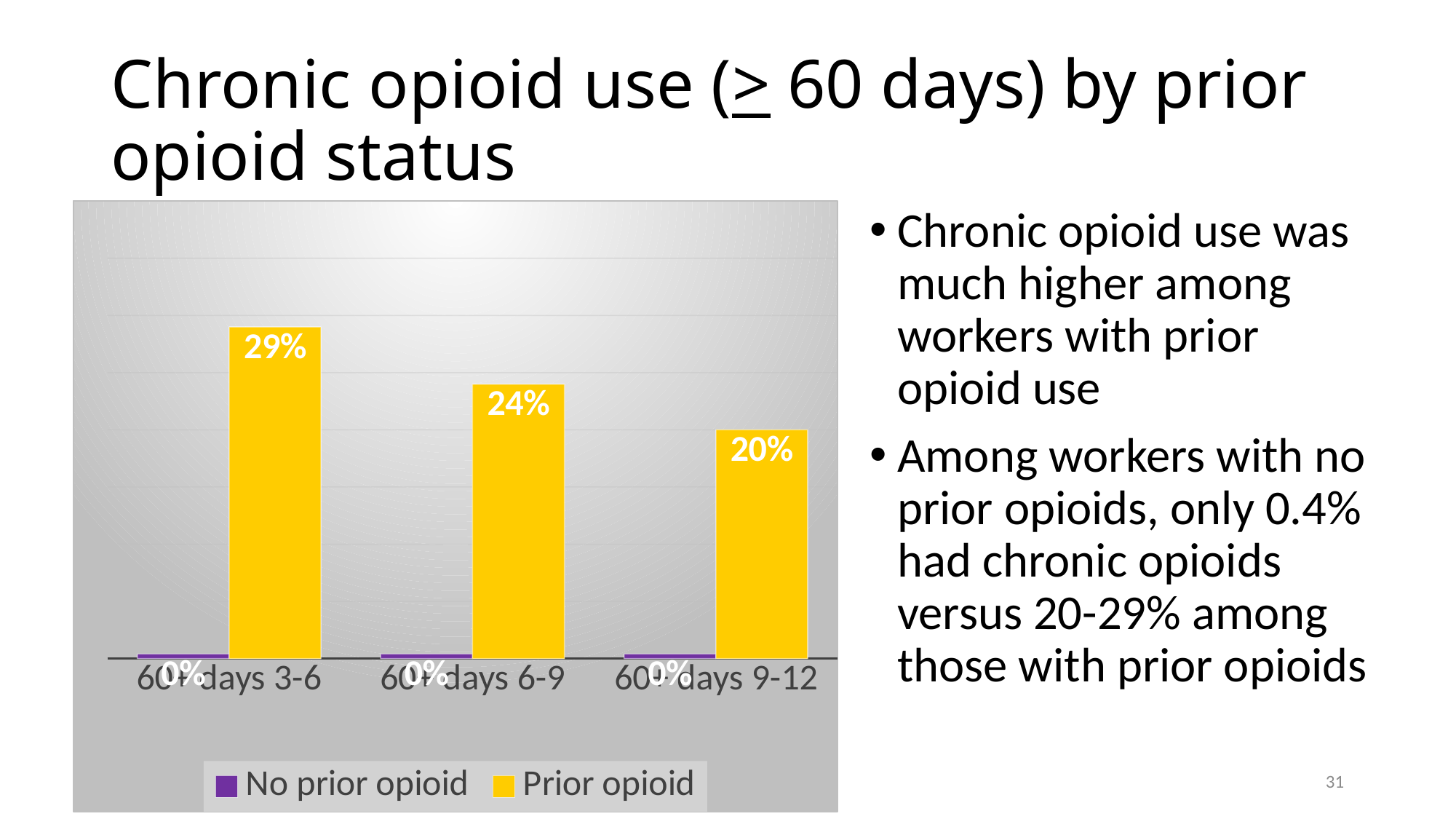
How many categories are shown on the x axis? 3 Which is larger, the Prior opioid value for 60+ days 6-9 or for 60+ days 9-12? 60+ days 6-9 What is the value for Prior opioid in the 60+ days 6-9 category? 24% What is the value for Prior opioid in the 60+ days 3-6 category? 29% What kind of chart is shown on the slide? Bar chart How many series does the legend list? 2 What value is labelled for No prior opioid in the 60+ days 3-6 category? 0% What is the value for Prior opioid in the 60+ days 9-12 category? 20% Do the Prior opioid values rise or fall from left to right across the categories? Fall Which category has the lowest Prior opioid value? 60+ days 9-12 Which category has the highest Prior opioid value? 60+ days 3-6 What is the difference between the Prior opioid values for 60+ days 3-6 and 60+ days 9-12? 9%